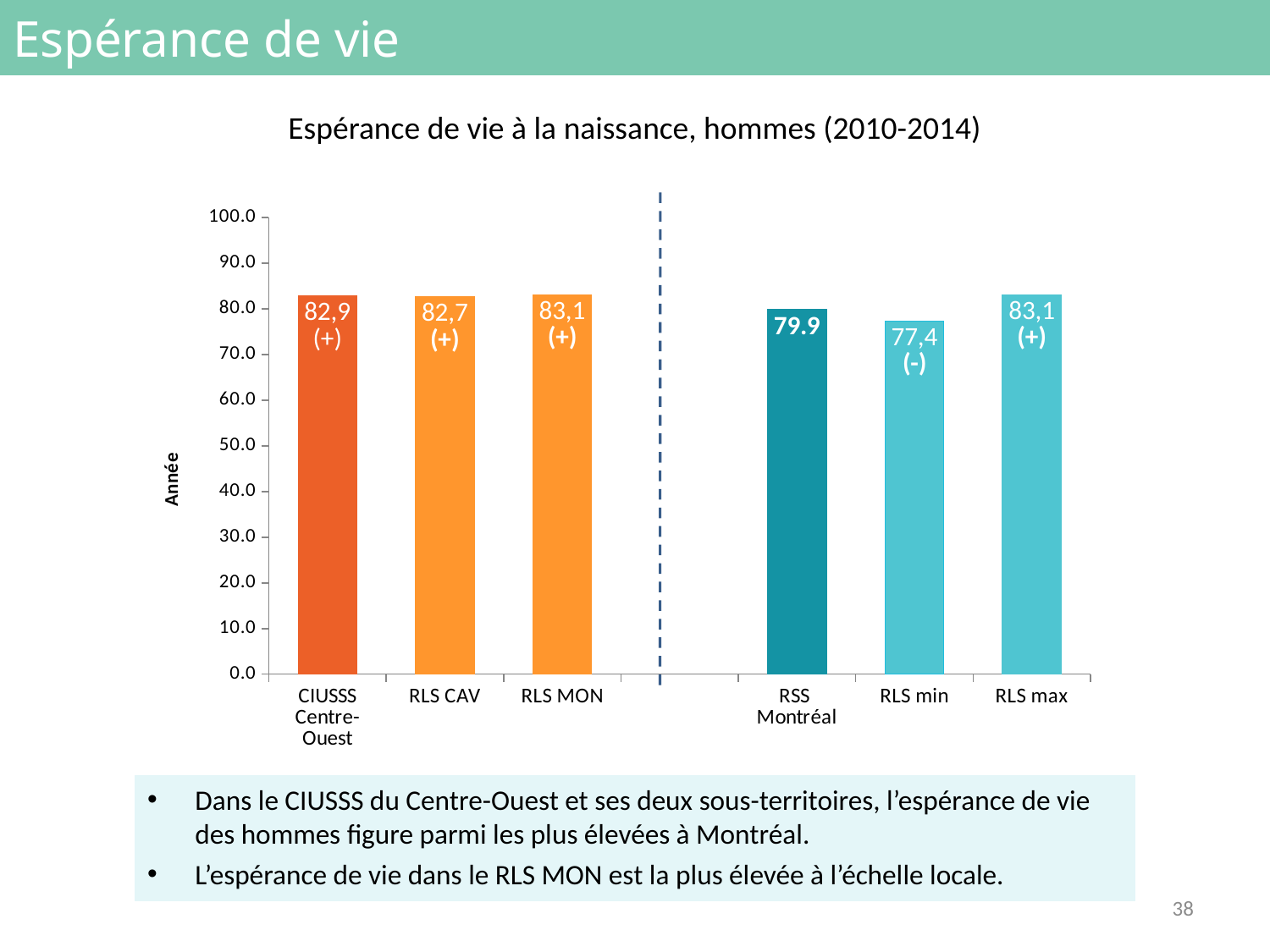
What is the value for CIUSSS Centre-Ouest? 82,9 What is the title of the chart? Espérance de vie à la naissance, hommes (2010-2014) Is the value for RLS min greater or less than 80.0? less What is the value for RSS Montréal? 79.9 What is the value for RLS min? 77,4 How many categories are shown on the x axis? 6 Which category has the lowest value? RLS min What is the difference between the values for CIUSSS Centre-Ouest and RSS Montréal? 3,0 What kind of chart is shown on the slide? bar chart Which is larger, the value for RLS CAV or the value for RLS min? RLS CAV What is the difference between the values for RLS max and RLS min? 5,7 What is the value for RLS CAV? 82,7